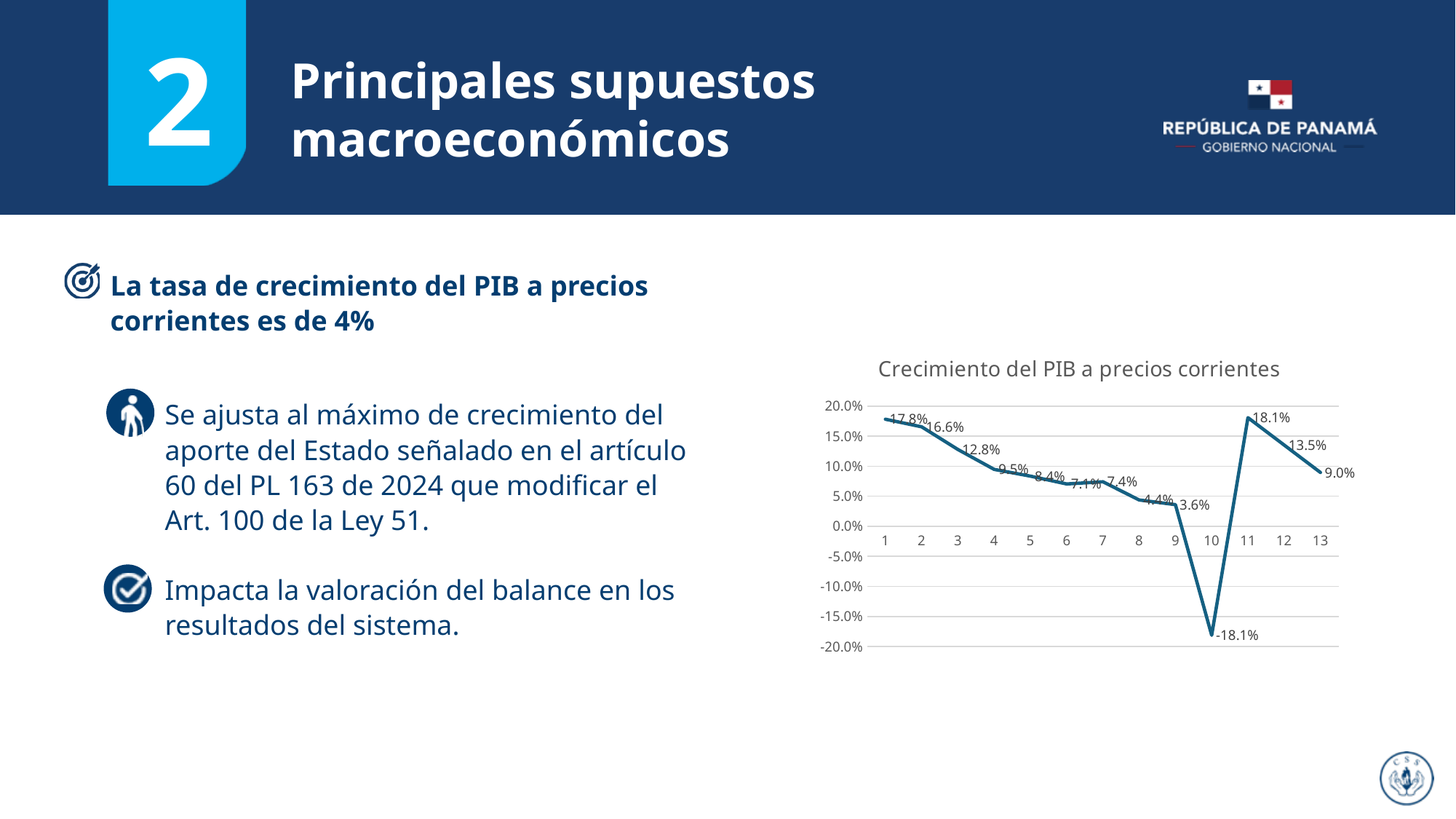
What is the value at point 4? 9.5% Which point has the lowest value? 10 Which point has the highest value? 11 How many data points are plotted on the line? 13 What type of chart is shown on the slide? line chart What is the value at point 13? 9.0% What is the title of the chart? Crecimiento del PIB a precios corrientes Which is larger, the value at point 6 or the value at point 7? point 7 What is the difference between the values at point 11 and point 12? 4.6% What is the value at point 1? 17.8% Do the values rise or fall from point 1 to point 9? fall What is the value at point 10? -18.1%